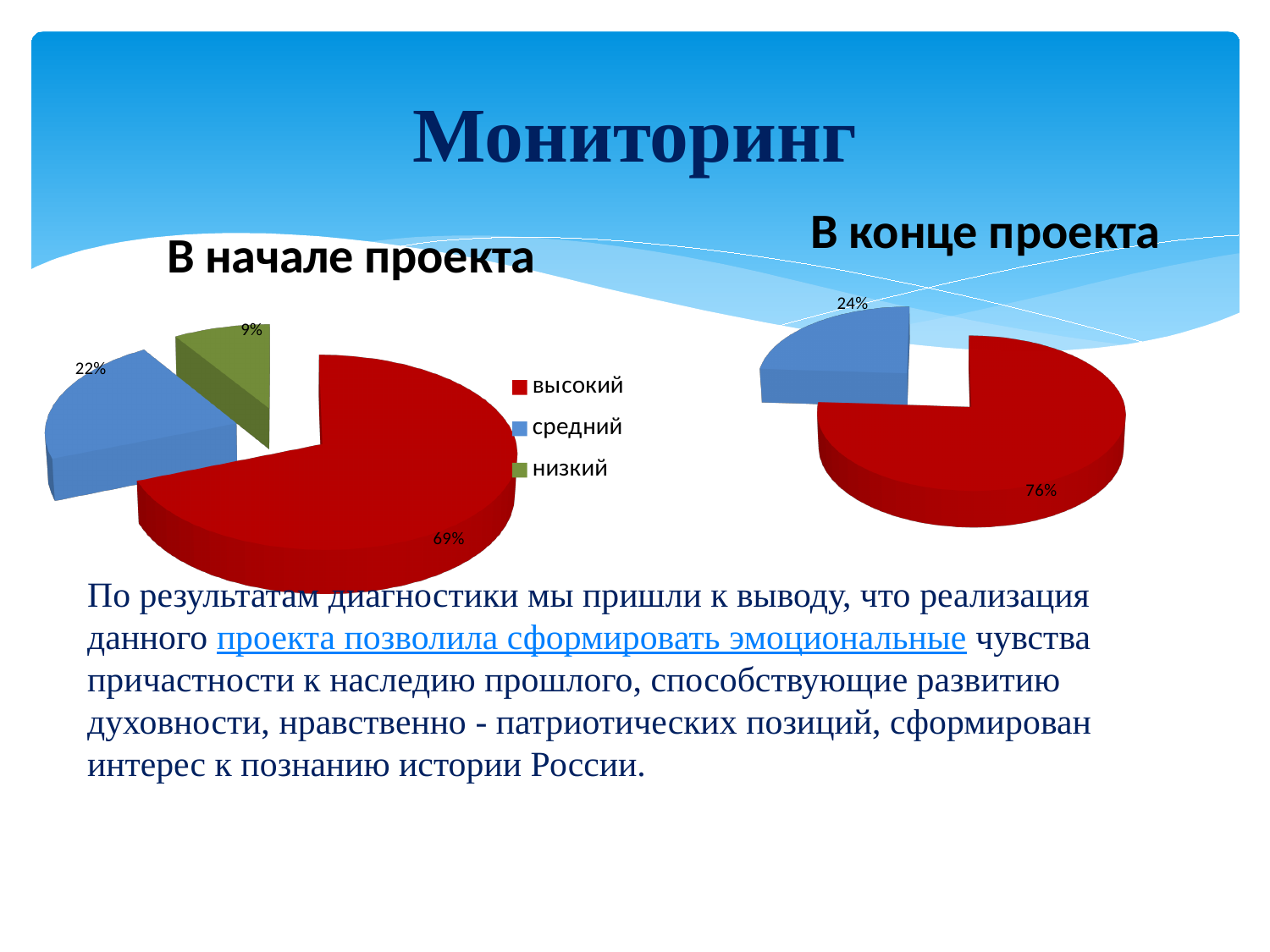
In the 'В начале проекта' chart, which category has the largest slice? высокий In the 'В начале проекта' chart, what share does the 'средний' slice have? 22% In the 'В начале проекта' chart, which category has the smallest slice? низкий How many entries does the legend of the 'В начале проекта' chart list? 3 How many slices does the 'В конце проекта' pie chart have? 2 Which is larger: the red slice in the 'В начале проекта' chart or the red slice in the 'В конце проекта' chart? В конце проекта What kind of chart is shown under the title 'В начале проекта'? pie chart In the 'В начале проекта' chart, what is the difference between the 'высокий' and 'средний' shares? 47% In the 'В конце проекта' chart, what share does the red slice have? 76% In the 'В начале проекта' chart, what share does the 'низкий' slice have? 9% In the 'В начале проекта' chart, what share does the 'высокий' slice have? 69% In the 'В конце проекта' chart, what share does the blue slice have? 24%